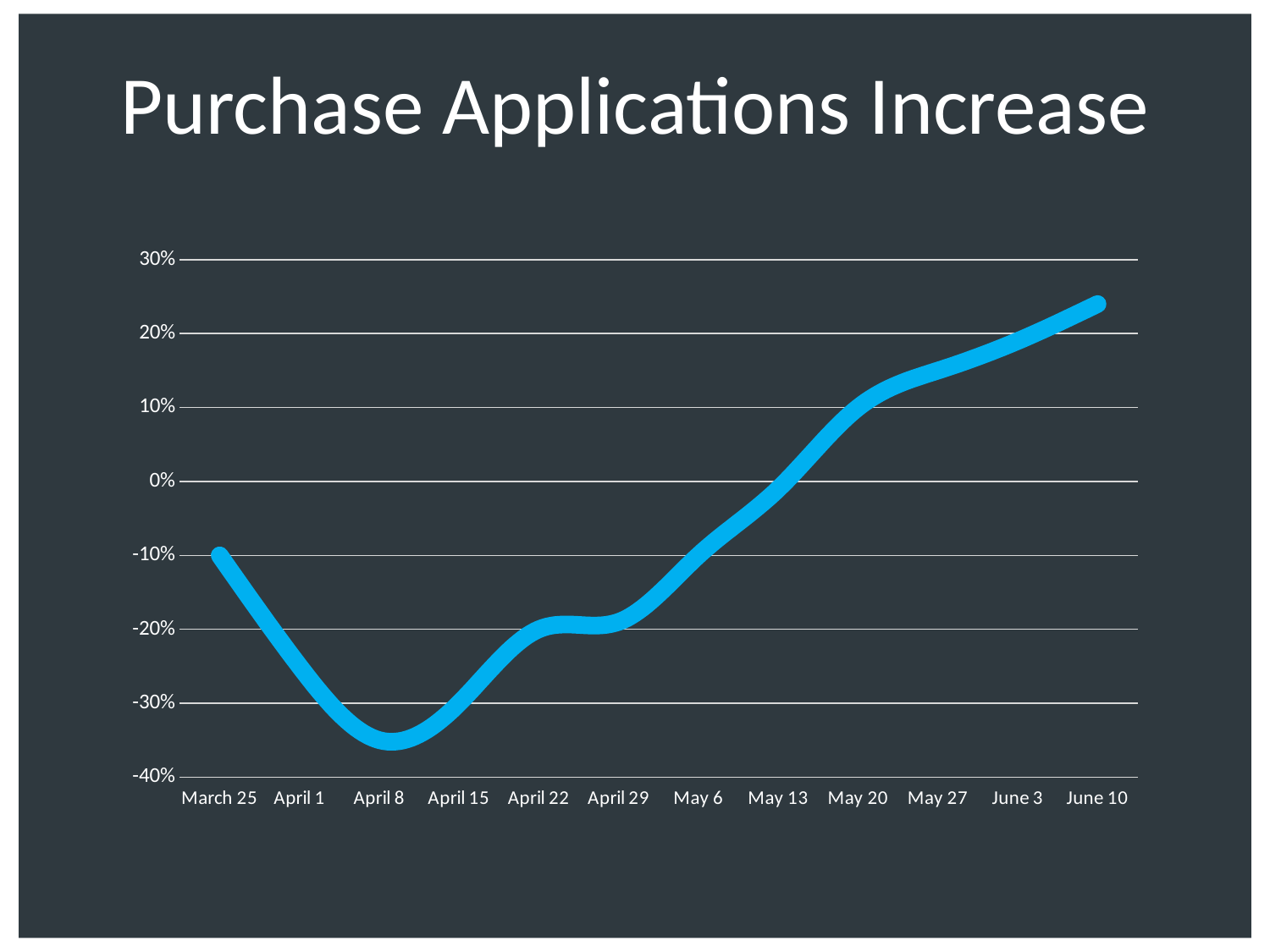
How many dates are plotted along the x axis? 12 Is the value for June 10 greater or less than 20%? greater What kind of chart is shown on the slide? line chart Is the value for May 20 greater or less than 0%? greater Do the values rise or fall from April 8 to June 10? rise Which date has the highest value on the chart? June 10 What is the title of the chart? Purchase Applications Increase Which has the larger value, March 25 or June 10? June 10 Is the value for April 1 greater or less than -20%? less Which date has the lowest value on the chart? April 8